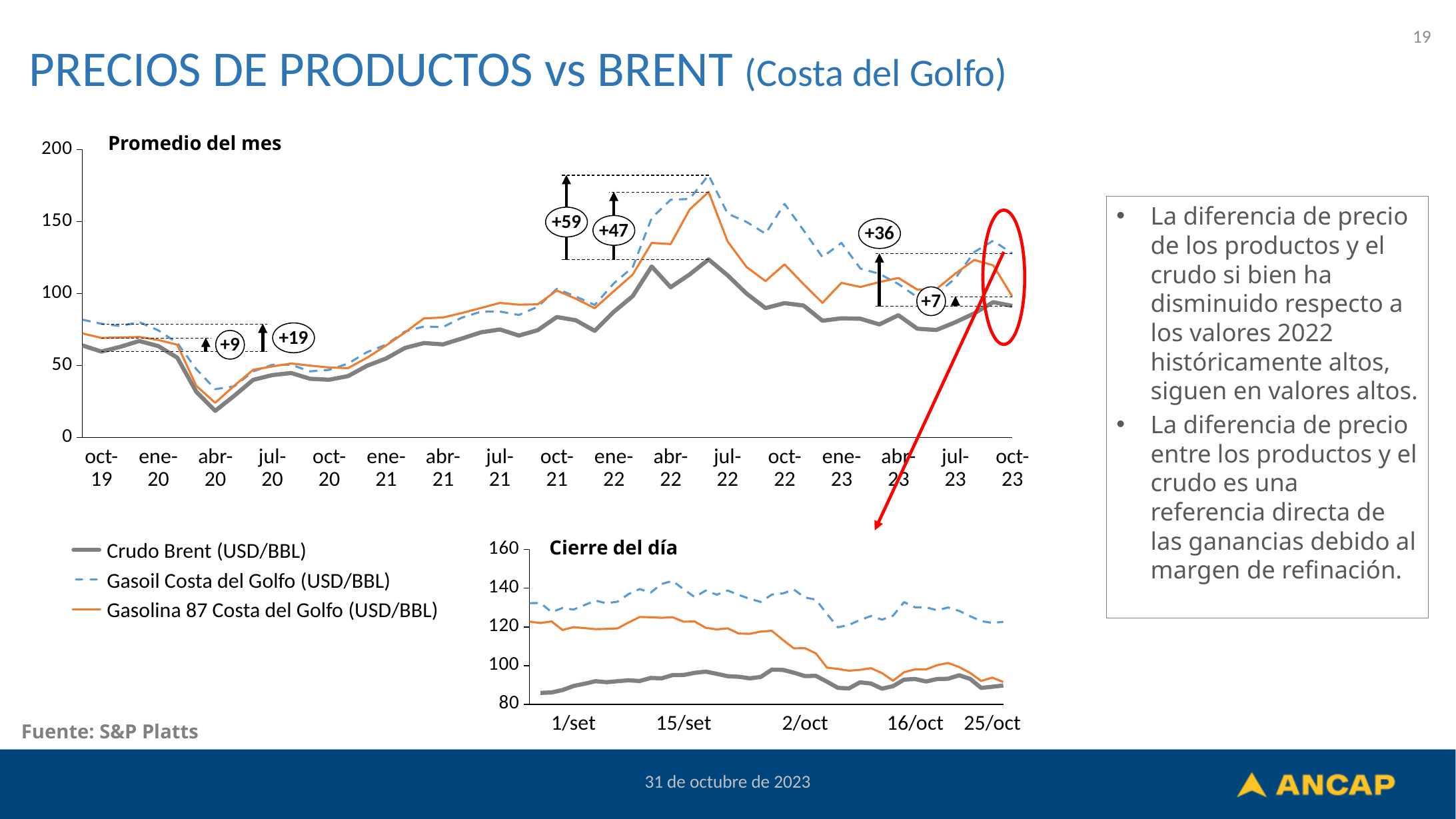
In the 'Promedio del mes' chart, does the Crudo Brent line rise or fall from oct-19 to abr-20? Fall In the 'Cierre del día' chart, is the value for Gasoil Costa del Golfo at 2/oct greater or less than 120? greater What kind of chart is the 'Promedio del mes' chart? Line chart In the 'Cierre del día' chart, is the value for Crudo Brent at 15/set greater or less than 100? less How many series does the legend list for the charts? 3 In the 'Promedio del mes' chart, what is the largest annotated price difference shown in a circle? +59 Which series is drawn with a dashed blue line? Gasoil Costa del Golfo (USD/BBL) In the 'Promedio del mes' chart, is the value for Gasoil Costa del Golfo at jul-22 greater or less than 150? greater In the 'Promedio del mes' chart, what is the smallest annotated price difference shown in a circle? +7 In the 'Promedio del mes' chart, which is higher at abr-22: Gasoil Costa del Golfo or Crudo Brent? Gasoil Costa del Golfo What is the title of the lower chart on the slide? Cierre del día